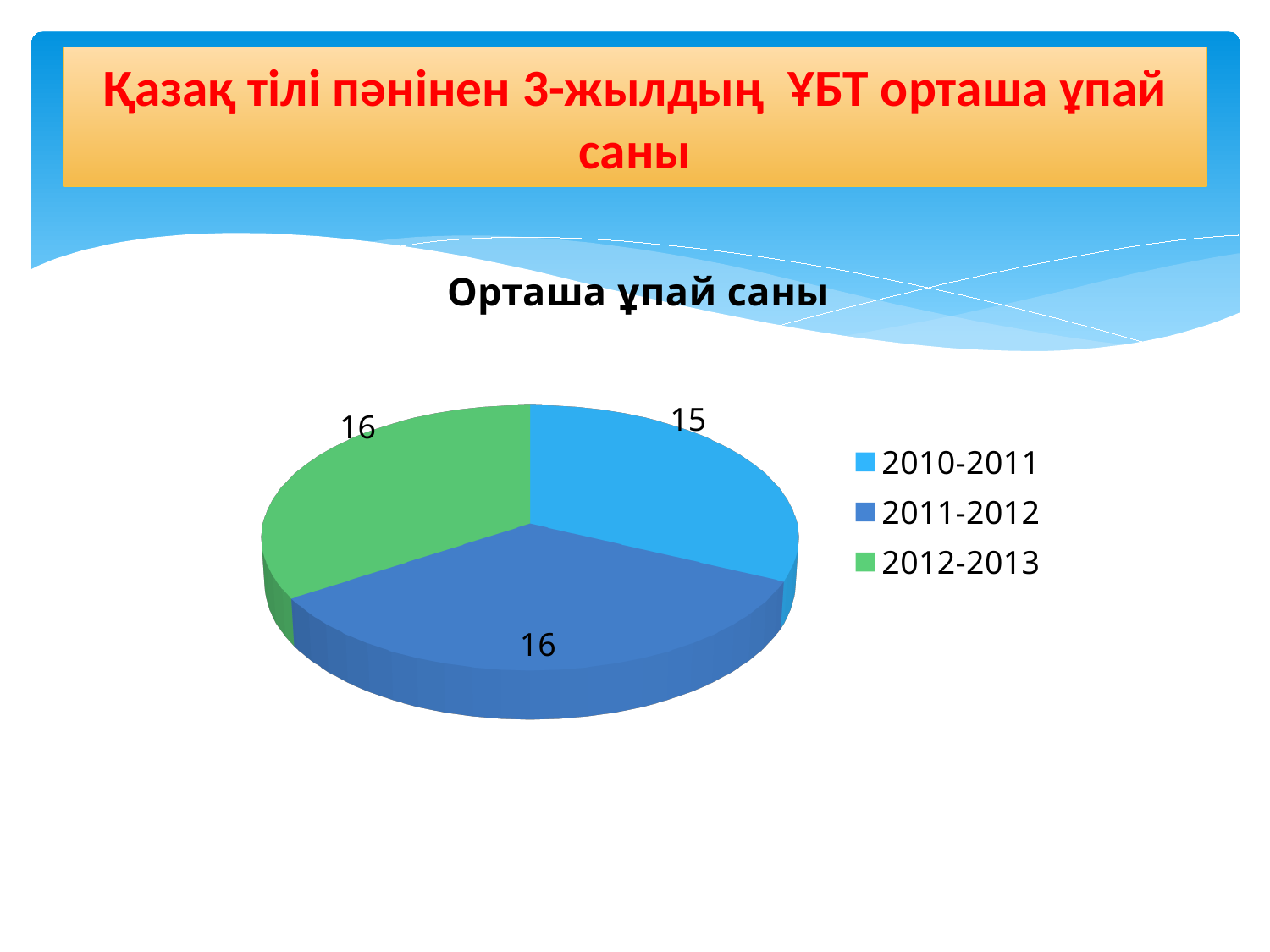
Which category is shown in green in the pie chart? 2012-2013 Which is larger, the value for 2010-2011 or the value for 2011-2012? 2011-2012 What is the value for 2011-2012 in the pie chart? 16 What is the difference between the values for 2011-2012 and 2010-2011? 1 What is the title of the chart? Орташа ұпай саны Which category has the lowest value in the pie chart? 2010-2011 What is the total of all slices in the pie chart? 47 What kind of chart is shown on the slide? Pie chart How many entries does the legend list? 3 What is the value for 2012-2013 in the pie chart? 16 How many slices does the pie chart have? 3 What is the value for 2010-2011 in the pie chart? 15